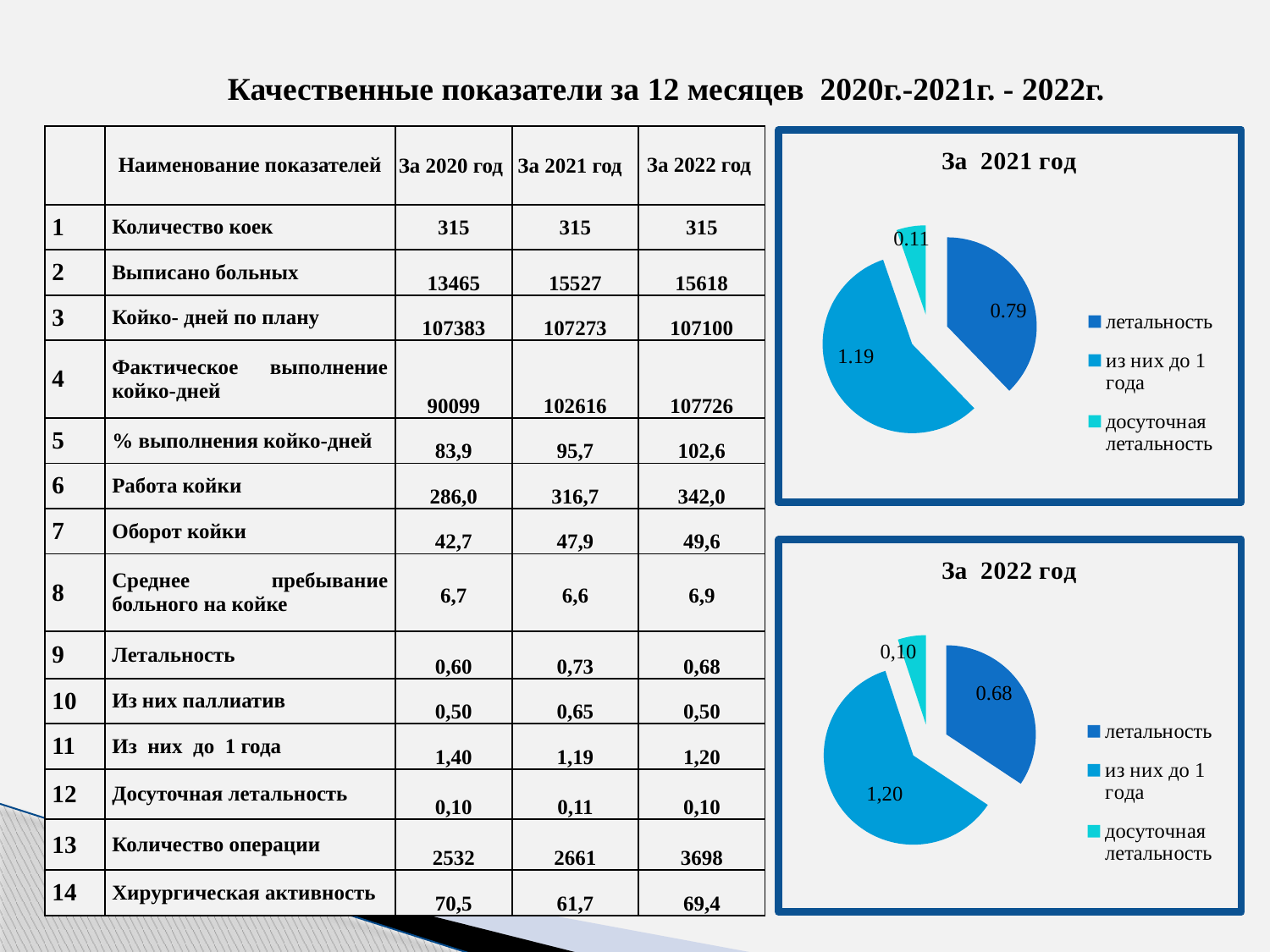
In the chart titled "За 2021 год", which category has the largest slice? из них до 1 года In the chart titled "За 2022 год", what is the value for "досуточная летальность"? 0,10 In the chart titled "За 2021 год", what is the value for "досуточная летальность"? 0.11 What type of chart is the chart titled "За 2022 год"? Pie chart In the chart titled "За 2022 год", which category has the smallest slice? досуточная летальность In the chart titled "За 2021 год", what is the value for "летальность"? 0.79 In the chart titled "За 2022 год", which is larger: the value for "летальность" or the value for "досуточная летальность"? летальность In the chart titled "За 2021 год", what is the value for "из них до 1 года"? 1.19 In the chart titled "За 2021 год", what is the difference between the values for "из них до 1 года" and "летальность"? 0.40 How many categories does the legend of the chart titled "За 2021 год" list? 3 In the chart titled "За 2022 год", what is the value for "из них до 1 года"? 1,20 In the chart titled "За 2022 год", what is the value for "летальность"? 0.68